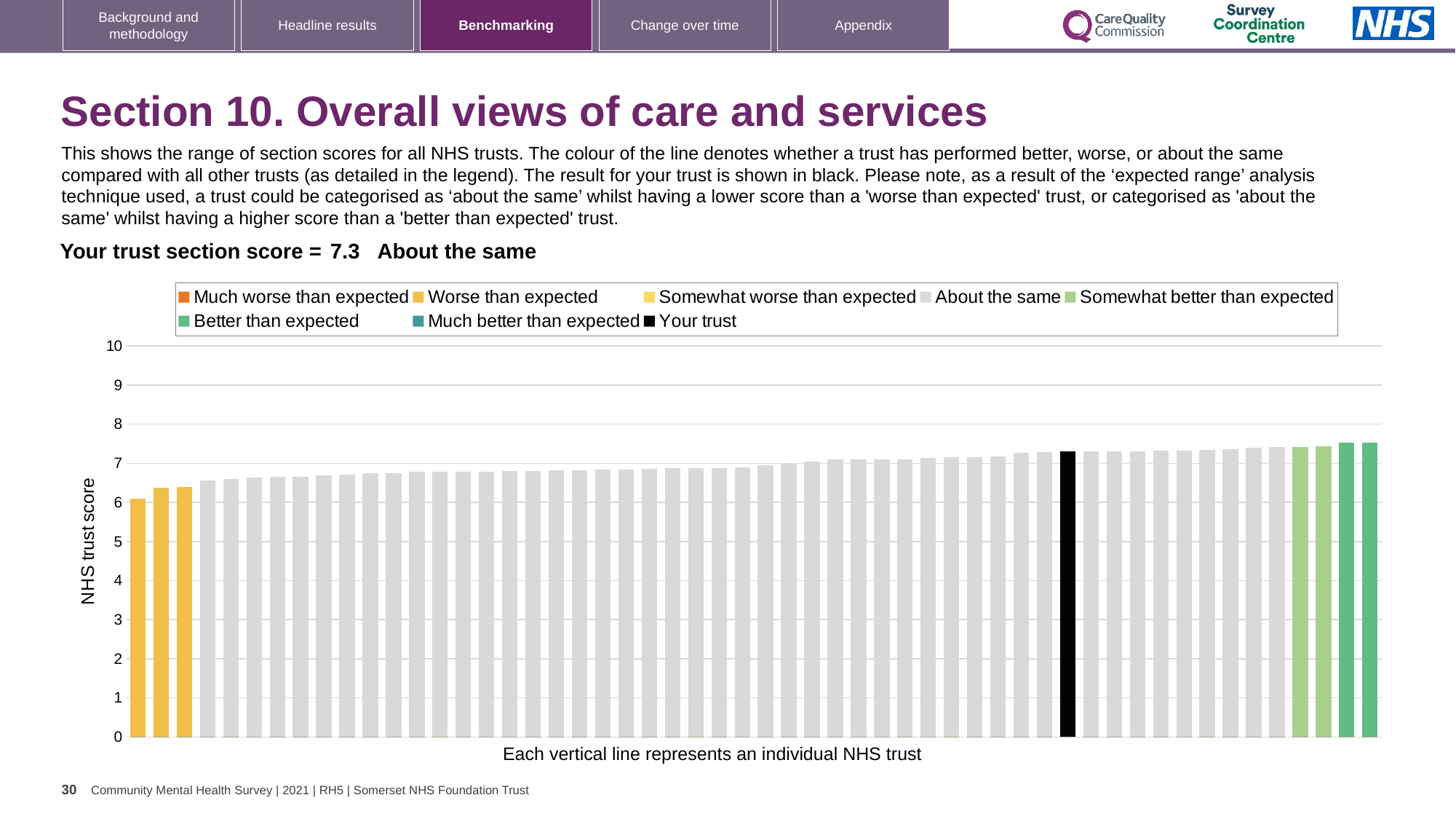
How many entries does the chart legend list? 8 Is the value of the leftmost (lowest) bar greater or less than 7? less What kind of chart is shown on the slide? bar chart What is the section score for your trust shown on the slide? 7.3 What colour is the bar representing your trust? black Do the bar values rise or fall moving from left to right along the x axis? rise Is the value of the black bar (your trust) greater or less than 7? greater What is the label on the vertical axis of the chart? NHS trust score Is the value of the rightmost (highest) bar greater or less than 8? less How many bars are coloured green (somewhat better or better than expected)? 4 Which category is your trust placed in for this section? About the same How many bars are coloured yellow (worse than expected)? 3